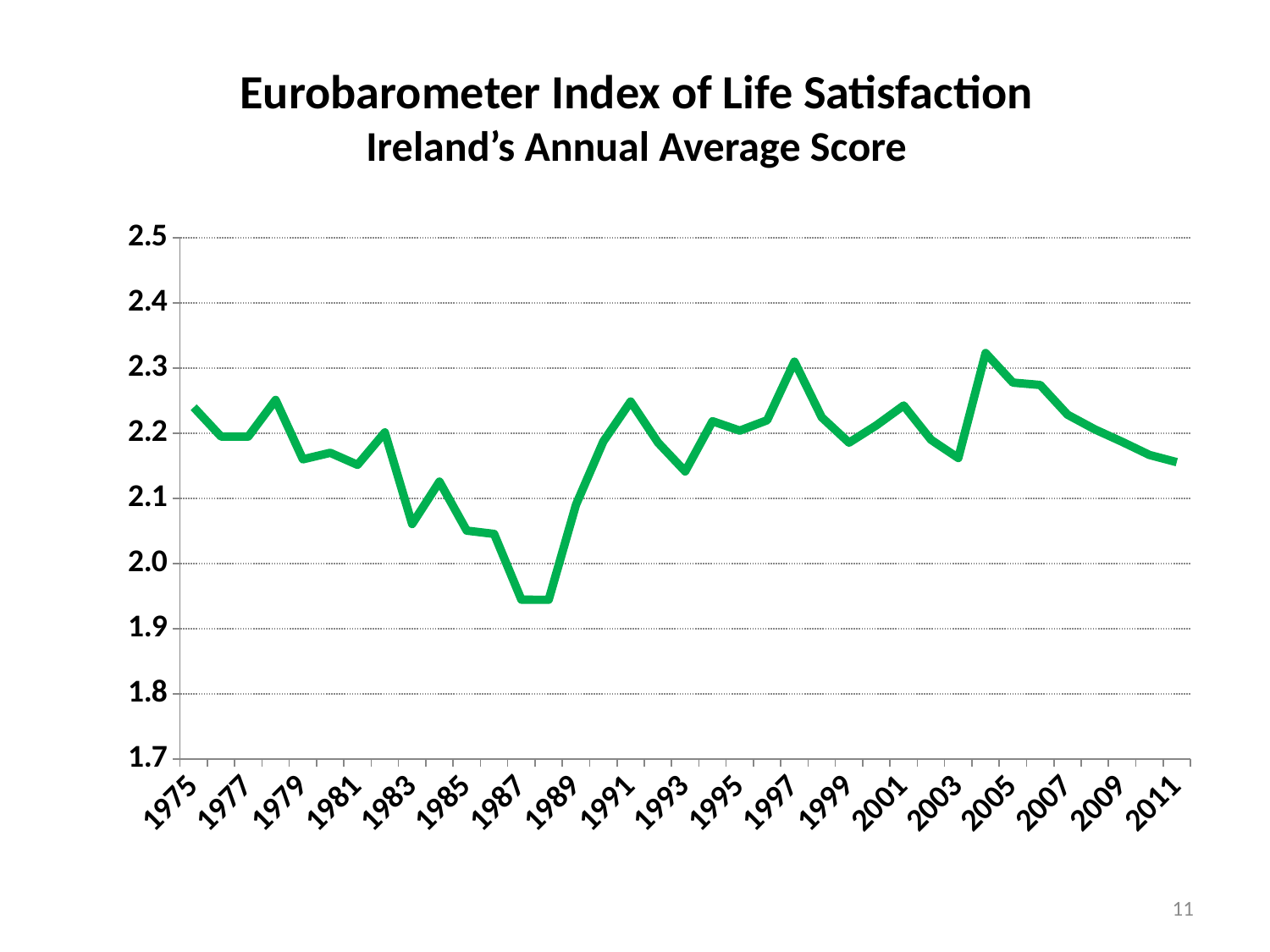
Which year has the larger value, 1975 or 1983? 1975 Is the value for 2005 greater or less than 2.2? greater Is the value for 1975 greater or less than 2.2? greater Which year has the larger value, 1987 or 1997? 1997 What is the title of the chart? Eurobarometer Index of Life Satisfaction What kind of chart is shown on the slide? Line chart Is the value for 1987 greater or less than 2.0? less Do the values rise or fall from 2005 to 2011? fall What colour is the line in the chart? Green